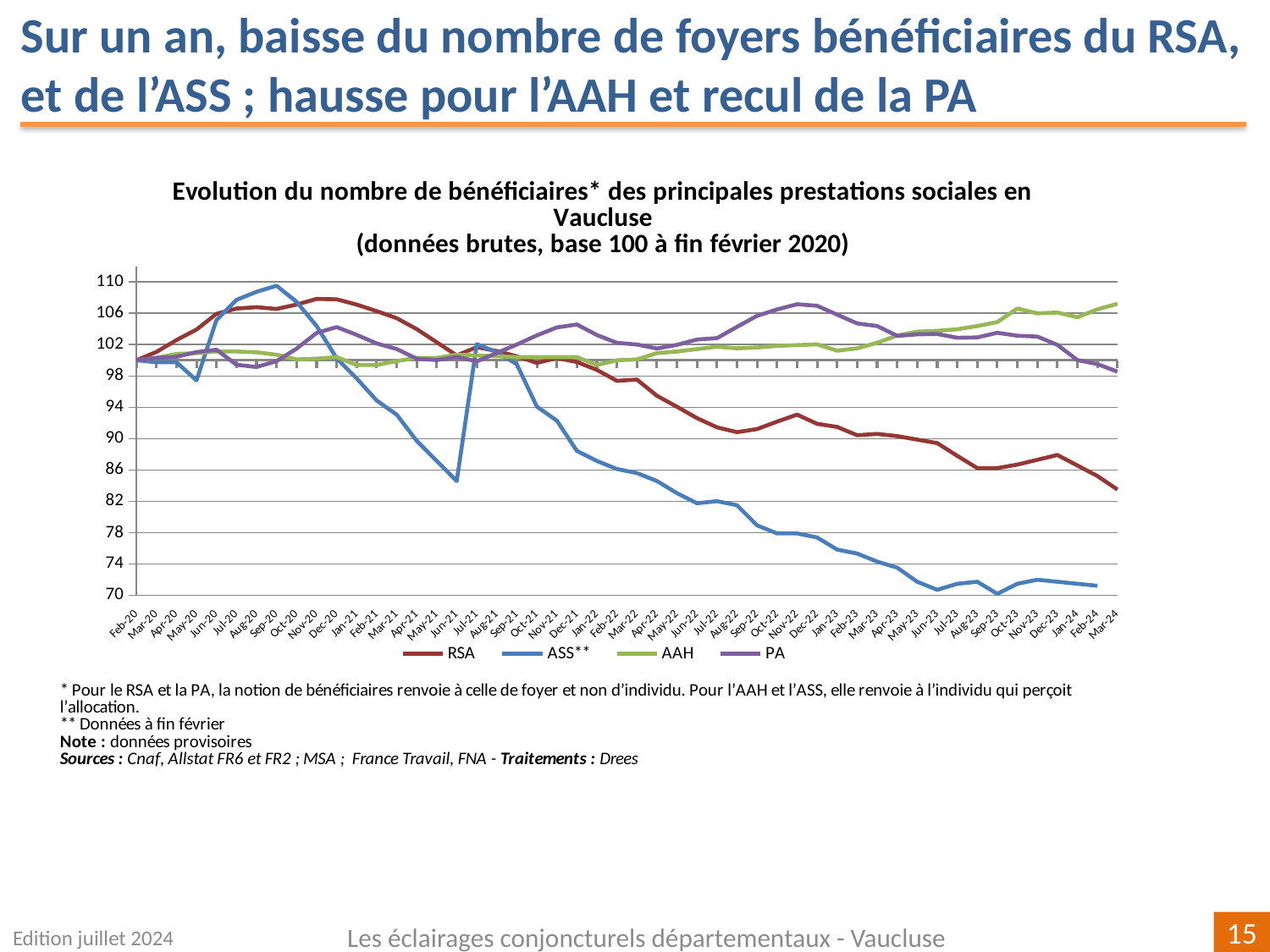
Which series has the highest value at Mar-24? AAH Is the value for RSA at Mar-24 greater or less than 86? less Does the ASS** series rise or fall overall from Feb-20 to Mar-24? fall How many series does the legend list? 4 Is the value for ASS** at Sep-20 greater or less than 106? greater Which series has the lowest value at Mar-24? RSA What kind of chart is shown on the slide? line chart Which series are listed in the legend? RSA, ASS**, AAH, PA Is the value for PA at Mar-24 greater or less than 102? less According to the chart title, what is the base 100 reference date? fin février 2020